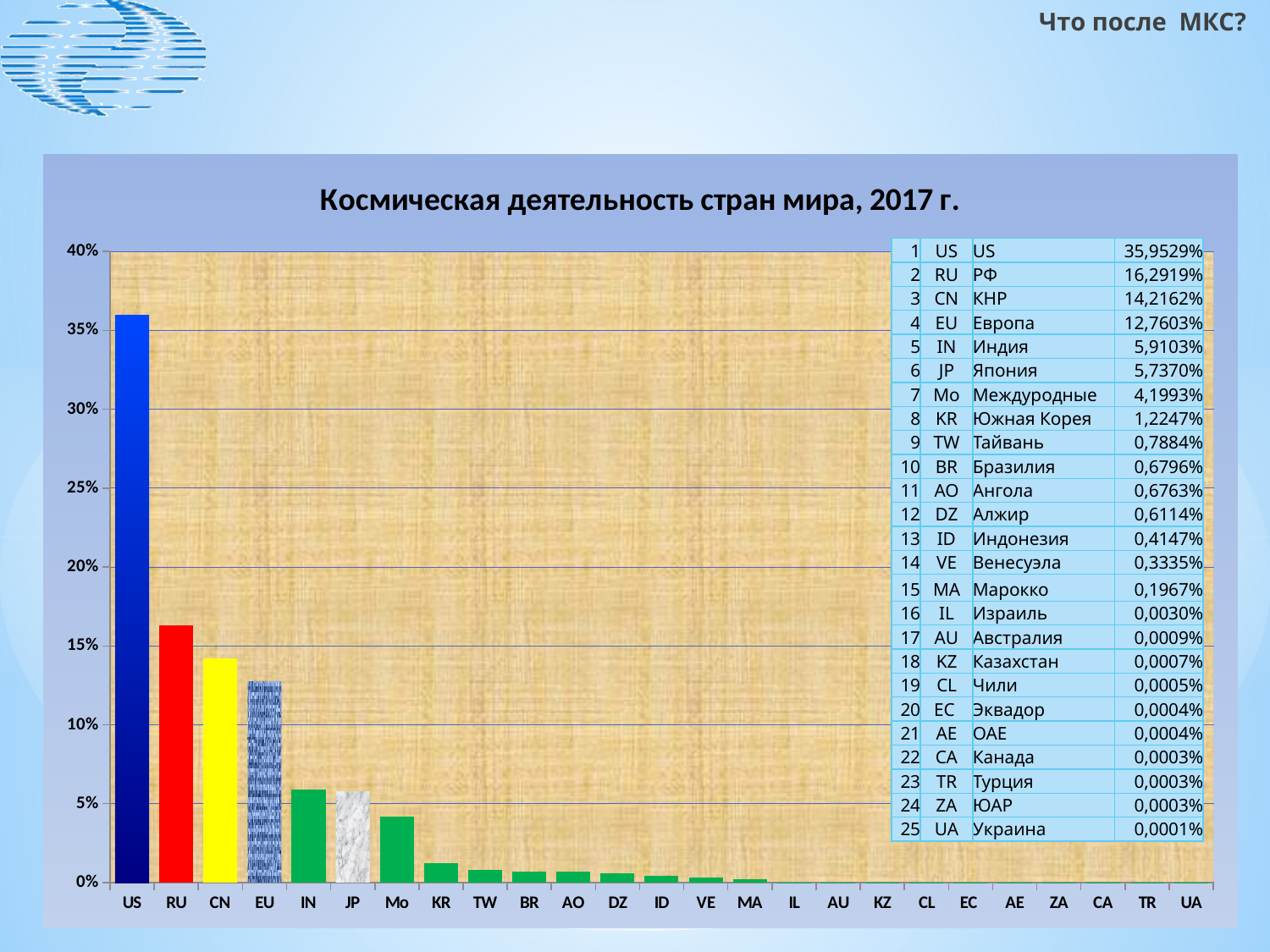
What kind of chart is shown on the slide? bar chart Which is larger, the value for IN or the value for JP? IN What is the value for RU? 16,2919% What is the title of the chart? Космическая деятельность стран мира, 2017 г. What is the difference between the values for US and RU? 19,6610% What is the value for Mo (Междуродные)? 4,1993% Which category has the highest value? US Do the values rise or fall from left to right along the x axis? fall How many countries/categories are plotted on the x axis? 25 What is the value for CN? 14,2162% Which category has the lowest value? UA Is the value for US greater or less than 35%? greater